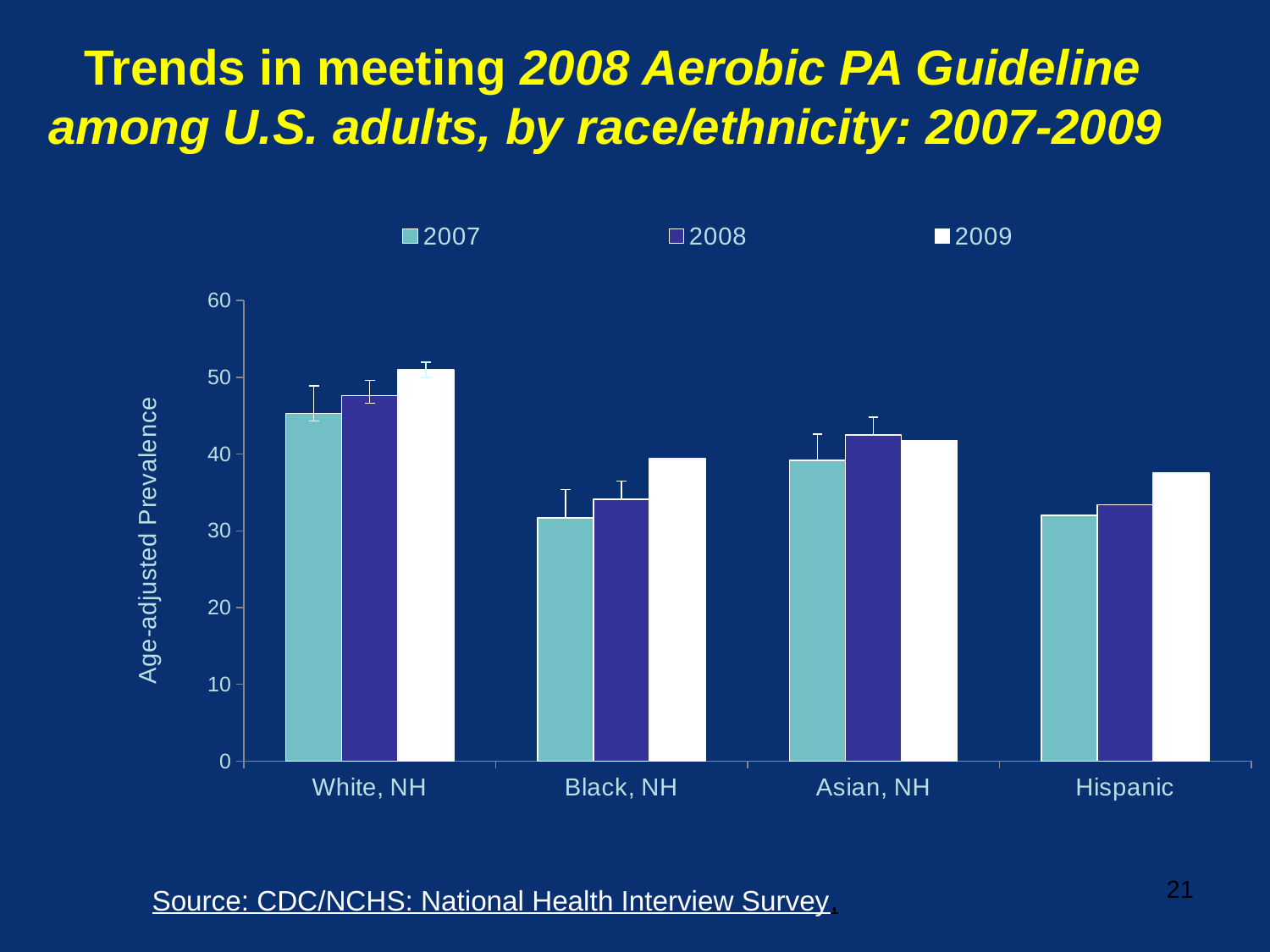
Do the values for White, NH rise or fall from 2007 to 2009? rise Is the 2007 value for Black, NH greater or less than 30? greater How many race/ethnicity categories are shown on the x axis? 4 What is the label on the y axis? Age-adjusted Prevalence What kind of chart is shown on the slide? bar chart Which is larger, the 2008 value for Black, NH or the 2008 value for Asian, NH? Asian, NH Is the 2007 value for White, NH greater or less than 40? greater Is the 2008 value for Asian, NH greater or less than 40? greater Which race/ethnicity group has the highest value for 2009? White, NH Which race/ethnicity group has the highest value for 2007? White, NH How many series does the legend list? 3